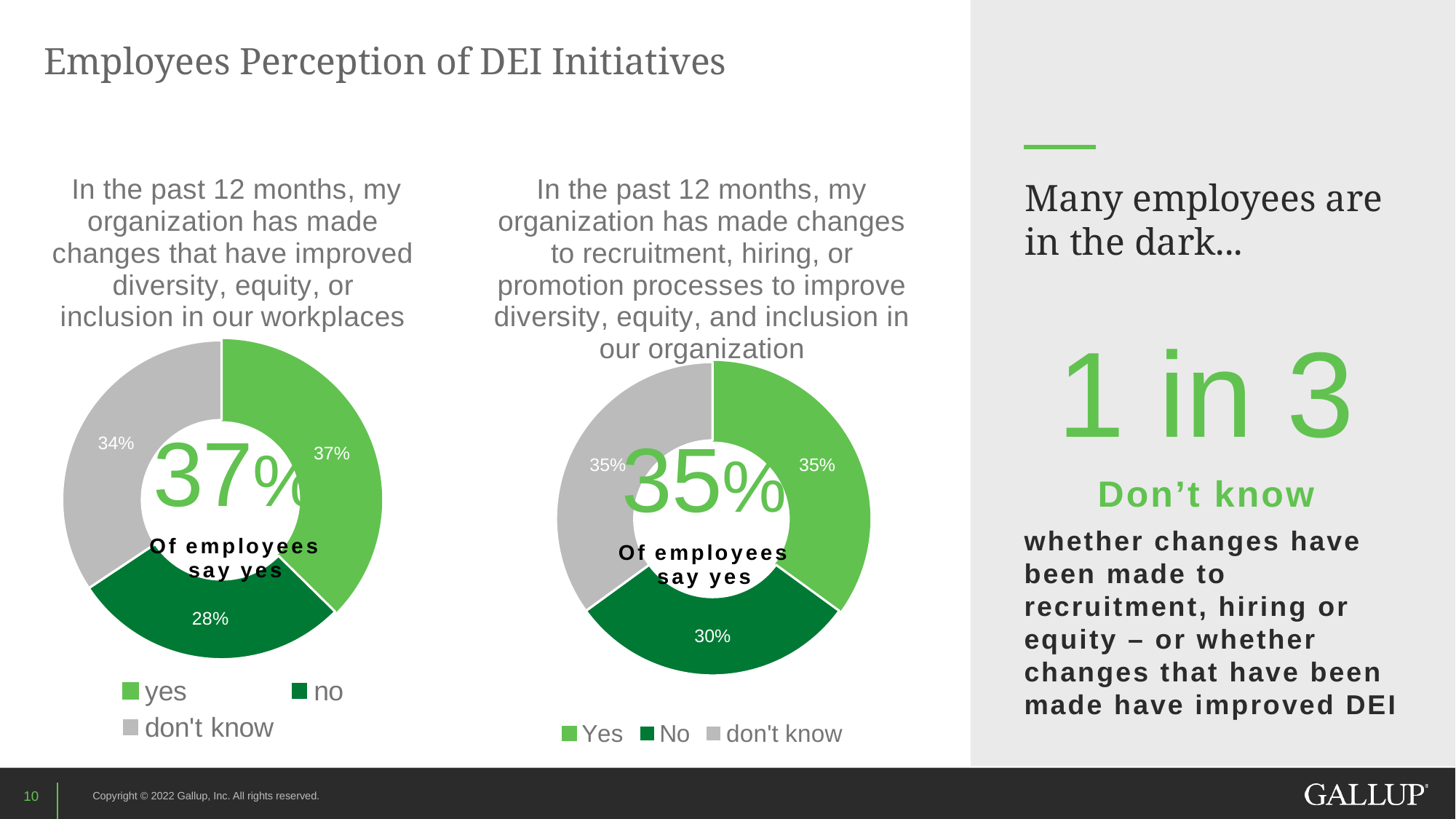
How many categories does the legend of the right chart (changes to recruitment, hiring, or promotion processes) list? 3 In the left chart (changes that have improved diversity, equity, or inclusion), what is the difference in percentage points between yes and no? 9 In the right chart (changes to recruitment, hiring, or promotion processes), what percentage of employees say No? 30% In the left chart (changes that have improved diversity, equity, or inclusion), which is larger: the share saying don't know or the share saying no? don't know In the right chart (changes to recruitment, hiring, or promotion processes), what percentage of employees say Yes? 35% In the right chart (changes to recruitment, hiring, or promotion processes), what is the difference in percentage points between don't know and No? 5 In the right chart (changes to recruitment, hiring, or promotion processes), which response has the smallest share? No In the left chart (changes that have improved diversity, equity, or inclusion), what percentage of employees say don't know? 34% In the left chart (changes that have improved diversity, equity, or inclusion), which response has the largest share? yes What kind of chart is used on the left side of the slide? Doughnut chart In the left chart (changes that have improved diversity, equity, or inclusion), what percentage of employees say yes? 37% In the left chart (changes that have improved diversity, equity, or inclusion), what percentage of employees say no? 28%